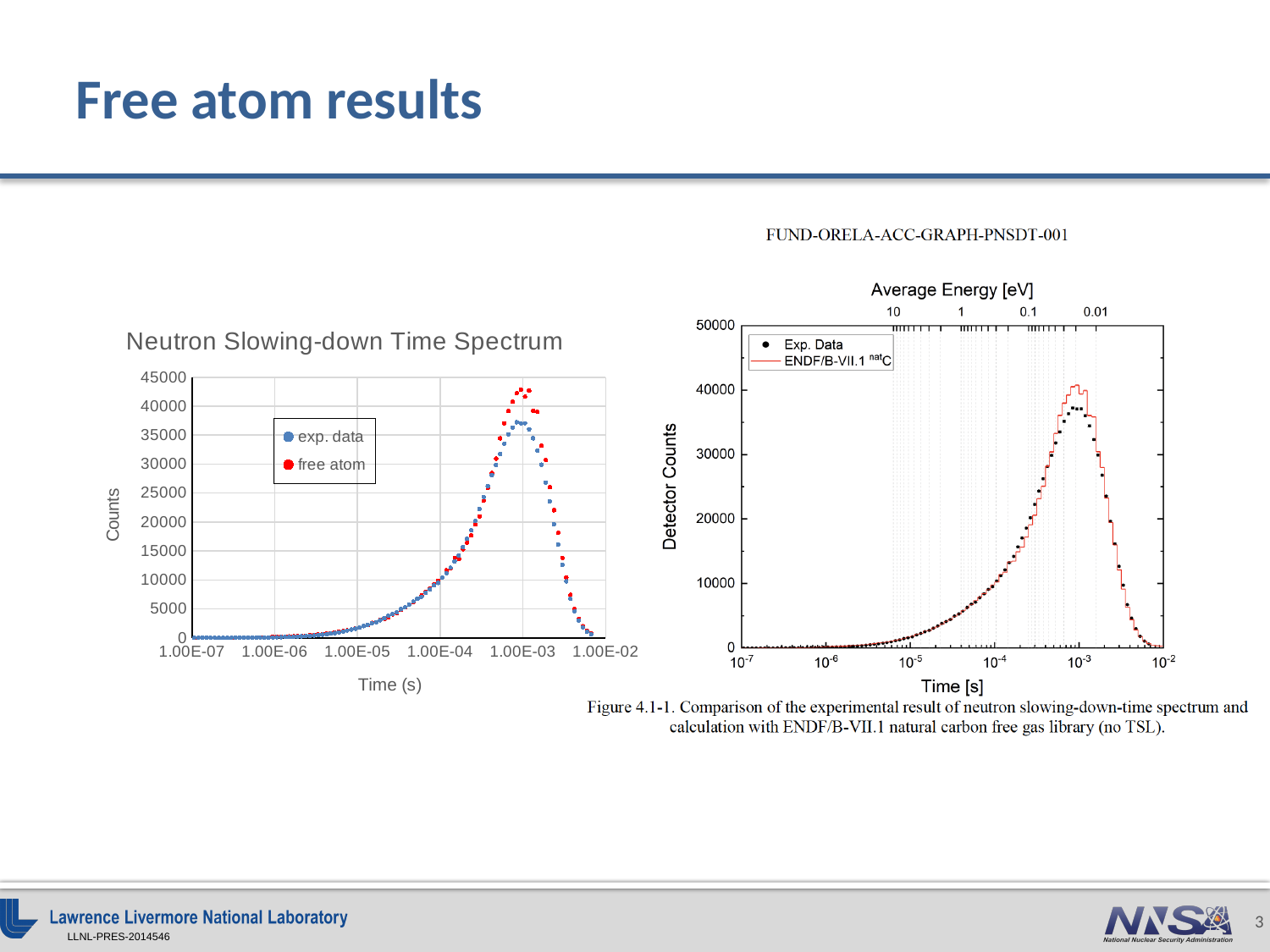
In the right-hand chart (FUND-ORELA-ACC-GRAPH-PNSDT-001), which series reaches the higher peak, Exp. Data or ENDF/B-VII.1 natC? ENDF/B-VII.1 natC In the 'Neutron Slowing-down Time Spectrum' chart, is the peak value of the free atom series greater or less than 40000? greater In the right-hand chart (FUND-ORELA-ACC-GRAPH-PNSDT-001), is the peak of the ENDF/B-VII.1 natC line greater or less than 40000 detector counts? greater In the 'Neutron Slowing-down Time Spectrum' chart, which series reaches the higher peak, exp. data or free atom? free atom In the 'Neutron Slowing-down Time Spectrum' chart, do the counts rise or fall as time increases from 1.00E-03 to 1.00E-02 s? fall In the 'Neutron Slowing-down Time Spectrum' chart, is the peak value of the exp. data series greater or less than 40000? less What is the y-axis label of the 'Neutron Slowing-down Time Spectrum' chart? Counts How many series does the legend of the right-hand chart (FUND-ORELA-ACC-GRAPH-PNSDT-001) list? 2 In the 'Neutron Slowing-down Time Spectrum' chart, do the counts rise or fall as time increases from 1.00E-05 to 1.00E-04 s? rise What kind of chart is the 'Neutron Slowing-down Time Spectrum' chart on the left? scatter chart In the 'Neutron Slowing-down Time Spectrum' chart, what are the two legend entries? exp. data and free atom How many series does the legend of the 'Neutron Slowing-down Time Spectrum' chart list? 2